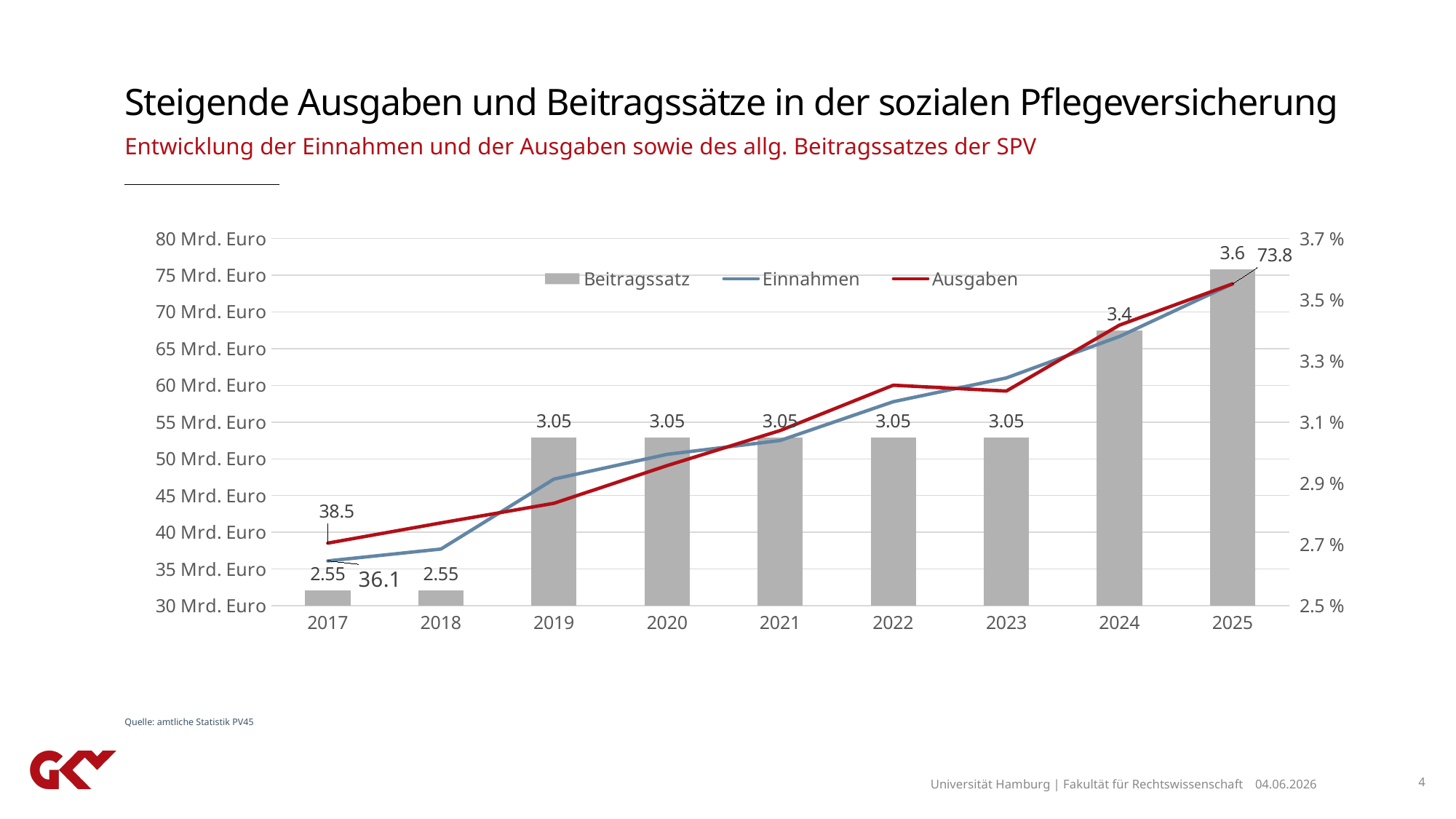
How many years are shown on the x axis? 9 What is the difference between the Beitragssatz in 2025 and in 2024? 0.2 What is the Beitragssatz value shown for 2017? 2.55 What value is labelled for Einnahmen in 2017? 36.1 In which year is the Beitragssatz bar highest? 2025 Is the Einnahmen value for 2019 greater or less than 50 Mrd. Euro? less Which year has the larger Beitragssatz, 2019 or 2024? 2024 What value is labelled for Ausgaben in 2017? 38.5 How many series does the legend list? 3 What is the Beitragssatz value shown for 2025? 3.6 What kind of chart is this? Combined bar and line chart Does the Beitragssatz rise or fall from 2017 to 2025? Rises